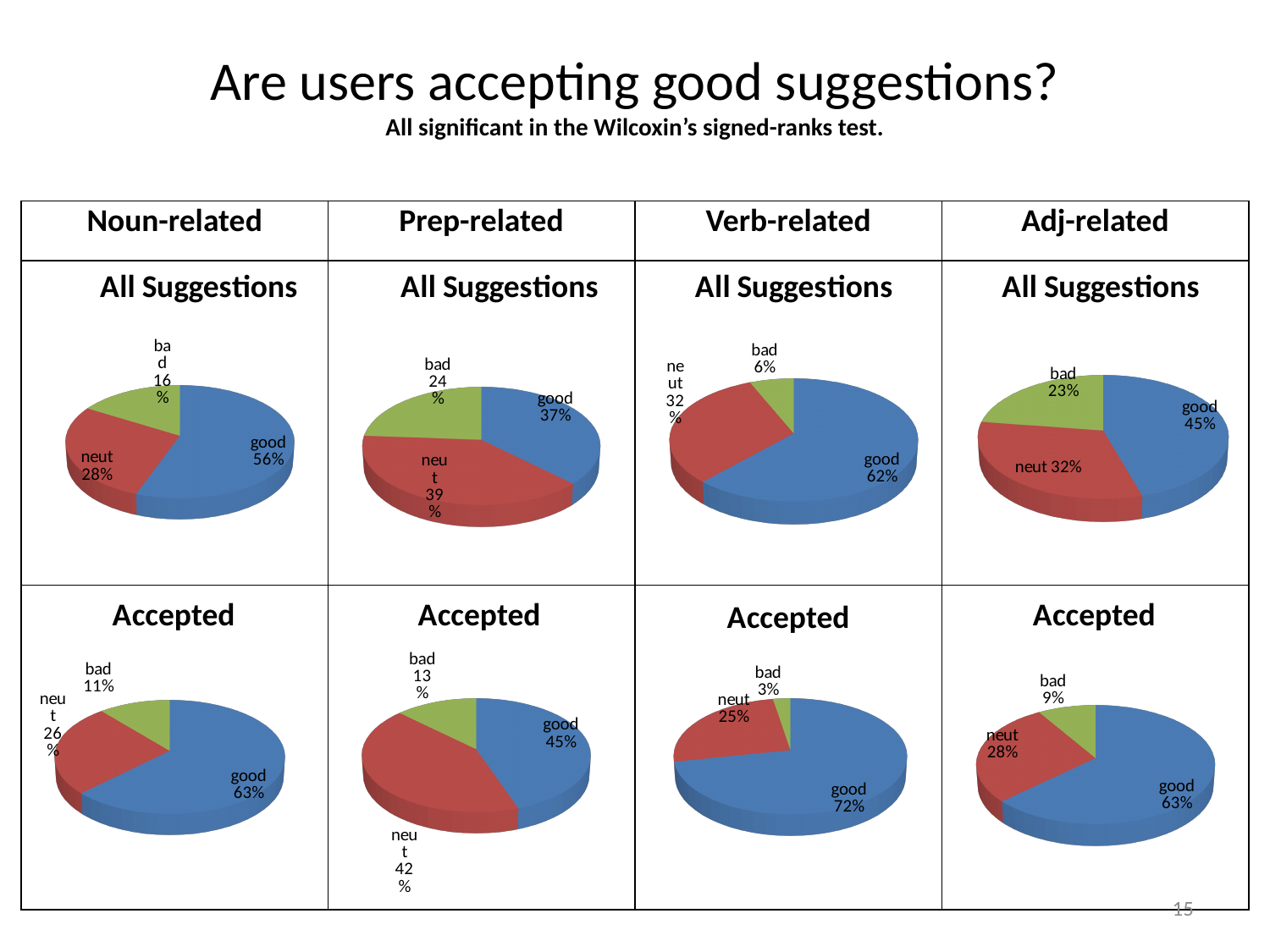
In the Verb-related All Suggestions pie chart, what share is labelled bad? 6% What type of chart is used in the Noun-related Accepted cell? Pie chart In the Noun-related All Suggestions pie chart, what share is labelled good? 56% In the Prep-related All Suggestions pie chart, what share is labelled neut? 39% In the Adj-related All Suggestions pie chart, what share is labelled bad? 23% In the Adj-related Accepted pie chart, what share is labelled good? 63% How many slices does the Adj-related All Suggestions pie chart have? 3 In the Prep-related All Suggestions pie chart, which slice is the smallest? bad What is the difference between the good share in the Verb-related Accepted pie chart and the good share in the Verb-related All Suggestions pie chart? 10% How many pie charts are shown on the slide? 8 In the Verb-related Accepted pie chart, which slice is the largest? good Which is larger: the neut share in the Prep-related Accepted pie chart or the neut share in the Noun-related Accepted pie chart? Prep-related Accepted